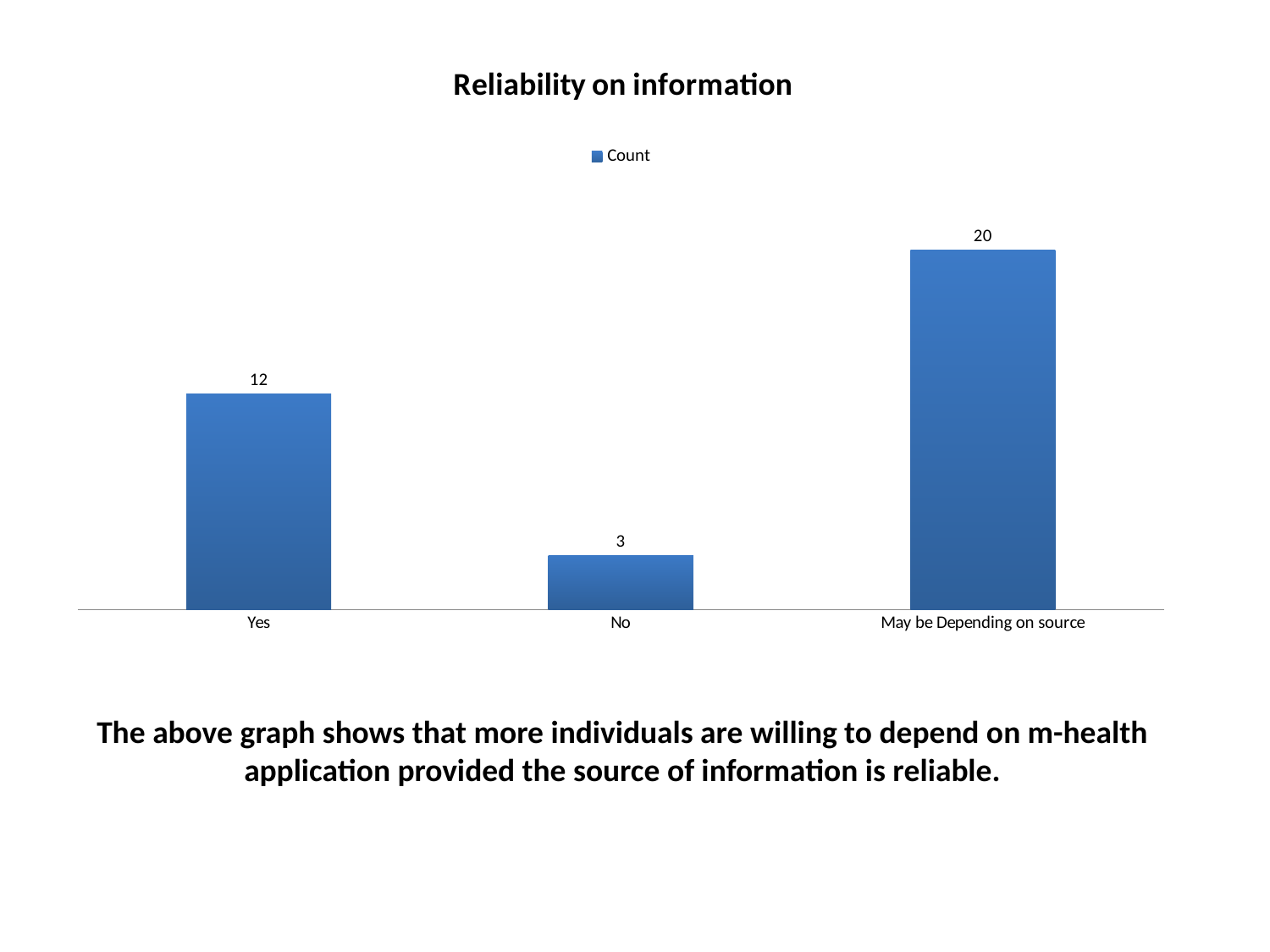
What is the Count for No? 3 What is the Count for May be Depending on source? 20 Which has a larger Count, Yes or No? Yes What is the difference between the Count for Yes and the Count for No? 9 What is the Count for Yes? 12 Which category has the highest Count? May be Depending on source How many categories are shown on the x axis? 3 Which category has the lowest Count? No How many series does the legend list? 1 What kind of chart is shown on the slide? Bar chart What is the title of the chart? Reliability on information What is the difference between the Count for May be Depending on source and the Count for Yes? 8